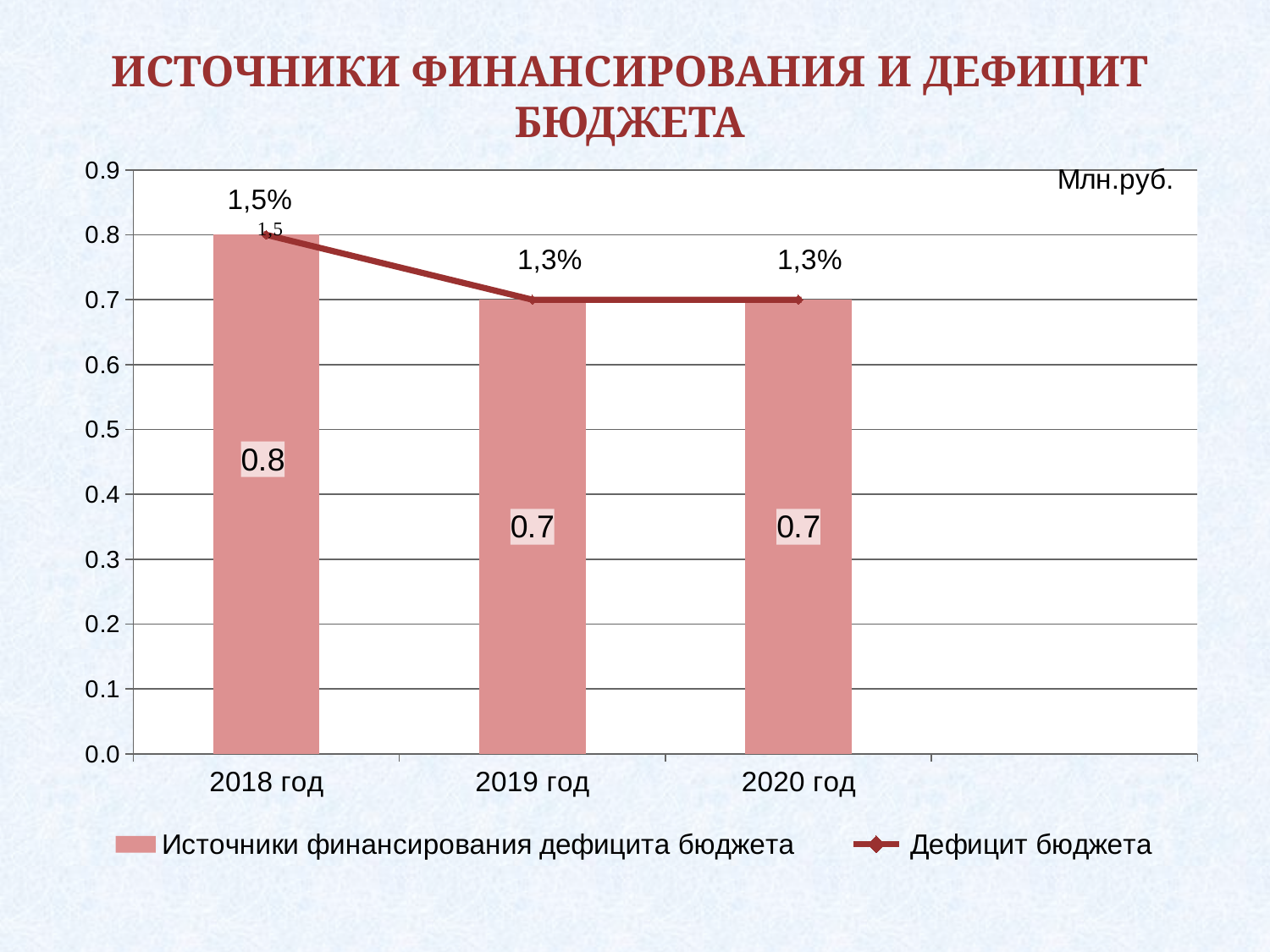
How many series does the legend list? 2 Is the Источники финансирования дефицита бюджета value for 2018 год larger or smaller than the value for 2020 год? larger Does the Дефицит бюджета line rise or fall from 2018 год to 2019 год? fall What percentage is shown for Дефицит бюджета in 2019 год? 1,3% Which year has the highest value for Источники финансирования дефицита бюджета? 2018 год How many years are shown on the x axis? 3 What is the title of the slide? ИСТОЧНИКИ ФИНАНСИРОВАНИЯ И ДЕФИЦИТ БЮДЖЕТА What is the value of Источники финансирования дефицита бюджета for 2018 год? 0.8 What is the difference between the Источники финансирования дефицита бюджета values for 2018 год and 2019 год? 0.1 What is the value of Источники финансирования дефицита бюджета for 2020 год? 0.7 What percentage is shown for Дефицит бюджета in 2018 год? 1,5% What unit is indicated in the top right corner of the chart? Млн.руб.